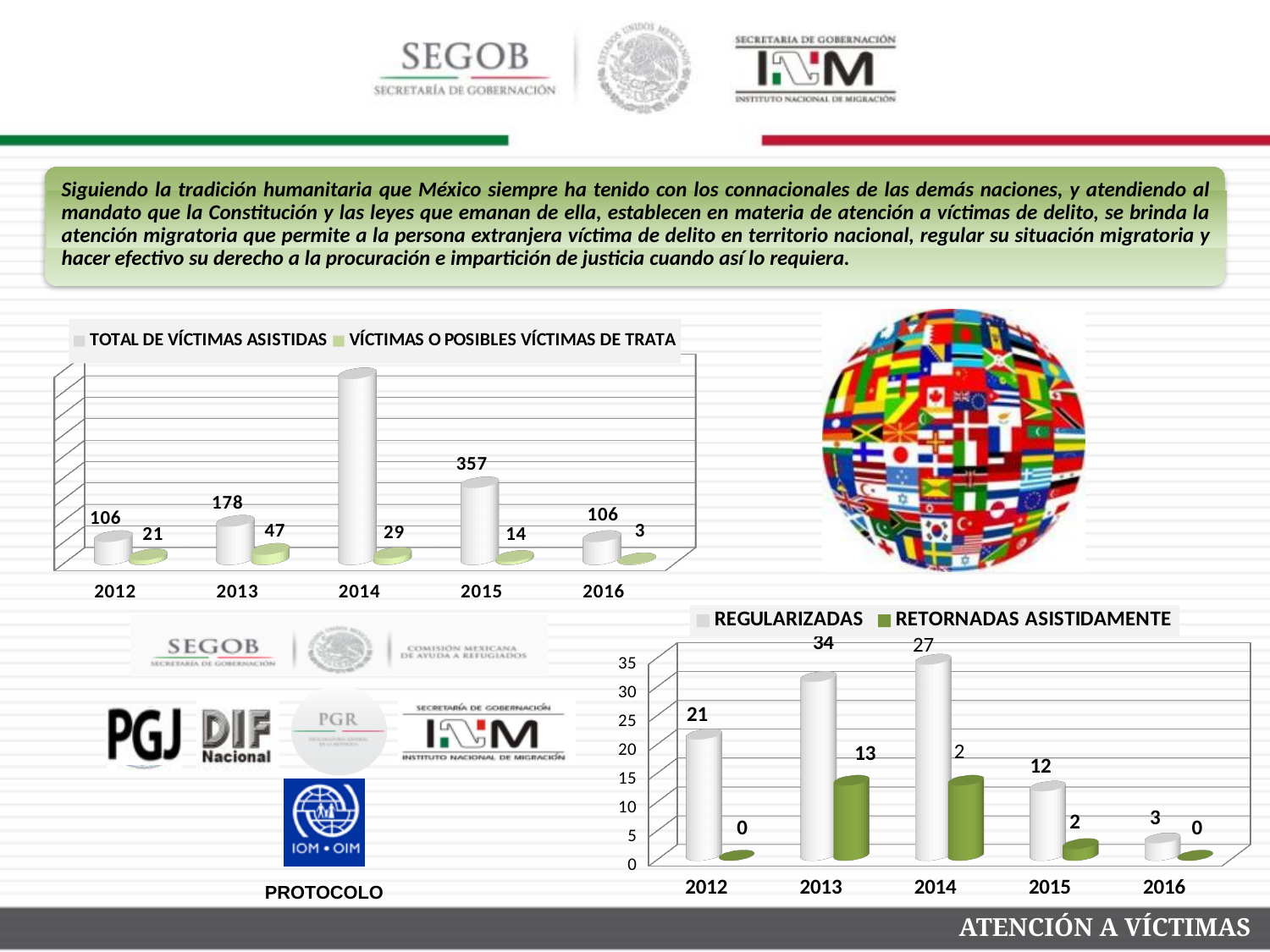
In the top-left chart, what is the difference between TOTAL DE VÍCTIMAS ASISTIDAS and VÍCTIMAS O POSIBLES VÍCTIMAS DE TRATA in 2012? 85 In the top-left chart, which year has the lowest value for VÍCTIMAS O POSIBLES VÍCTIMAS DE TRATA? 2016 In the top-left chart, what is the value of VÍCTIMAS O POSIBLES VÍCTIMAS DE TRATA for 2013? 47 What kind of chart is the bottom-right chart? bar chart In the top-left chart, which year has the highest value for TOTAL DE VÍCTIMAS ASISTIDAS? 2014 In the top-left chart, what is the value of TOTAL DE VÍCTIMAS ASISTIDAS for 2015? 357 In the bottom-right chart, what is the value of REGULARIZADAS for 2013? 34 In the bottom-right chart, how many years are shown on the x axis? 5 In the bottom-right chart, what is the value of RETORNADAS ASISTIDAMENTE for 2015? 2 In the bottom-right chart, is the value of REGULARIZADAS for 2012 greater or less than 20? greater In the top-left chart, how many series does the legend list? 2